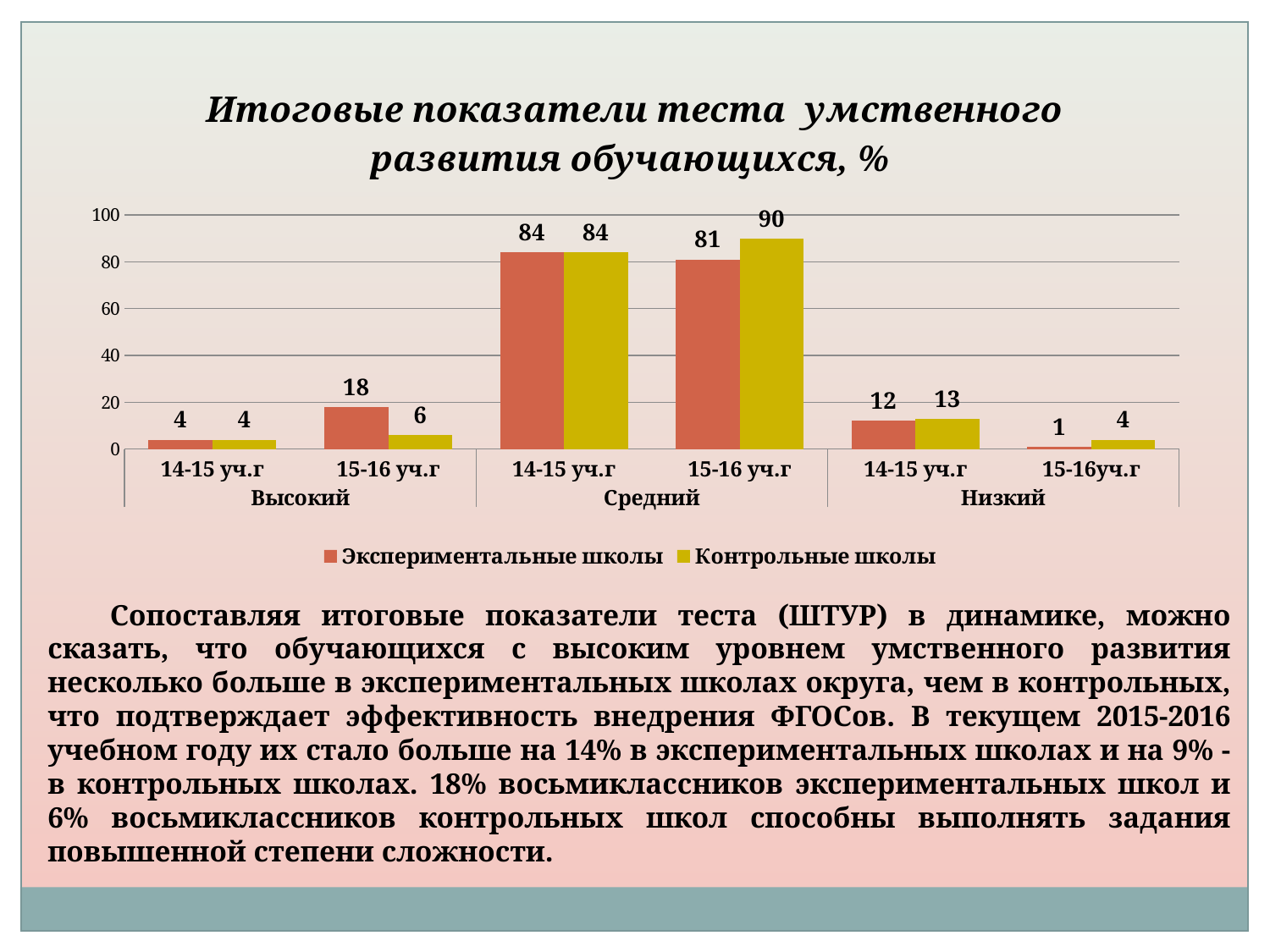
What is the value for Экспериментальные школы in the Низкий group for 15-16уч.г? 1 In the Средний group for 15-16 уч.г, which series has the larger value, Экспериментальные школы or Контрольные школы? Контрольные школы What is the value for Экспериментальные школы in the Высокий group for 15-16 уч.г? 18 What is the value for Контрольные школы in the Низкий group for 14-15 уч.г? 13 Which bar has the highest value on the chart? Контрольные школы, Средний, 15-16 уч.г (90) What kind of chart is shown on the slide? Bar chart Which colour represents Контрольные школы in the legend? Yellow What is the value for Контрольные школы in the Средний group for 15-16 уч.г? 90 Which bar has the lowest value on the chart? Экспериментальные школы, Низкий, 15-16уч.г (1) What is the difference between Экспериментальные школы and Контрольные школы in the Высокий group for 15-16 уч.г? 12 How many level groups (Высокий, Средний, Низкий) are shown on the x axis? 3 How many series does the legend list? 2